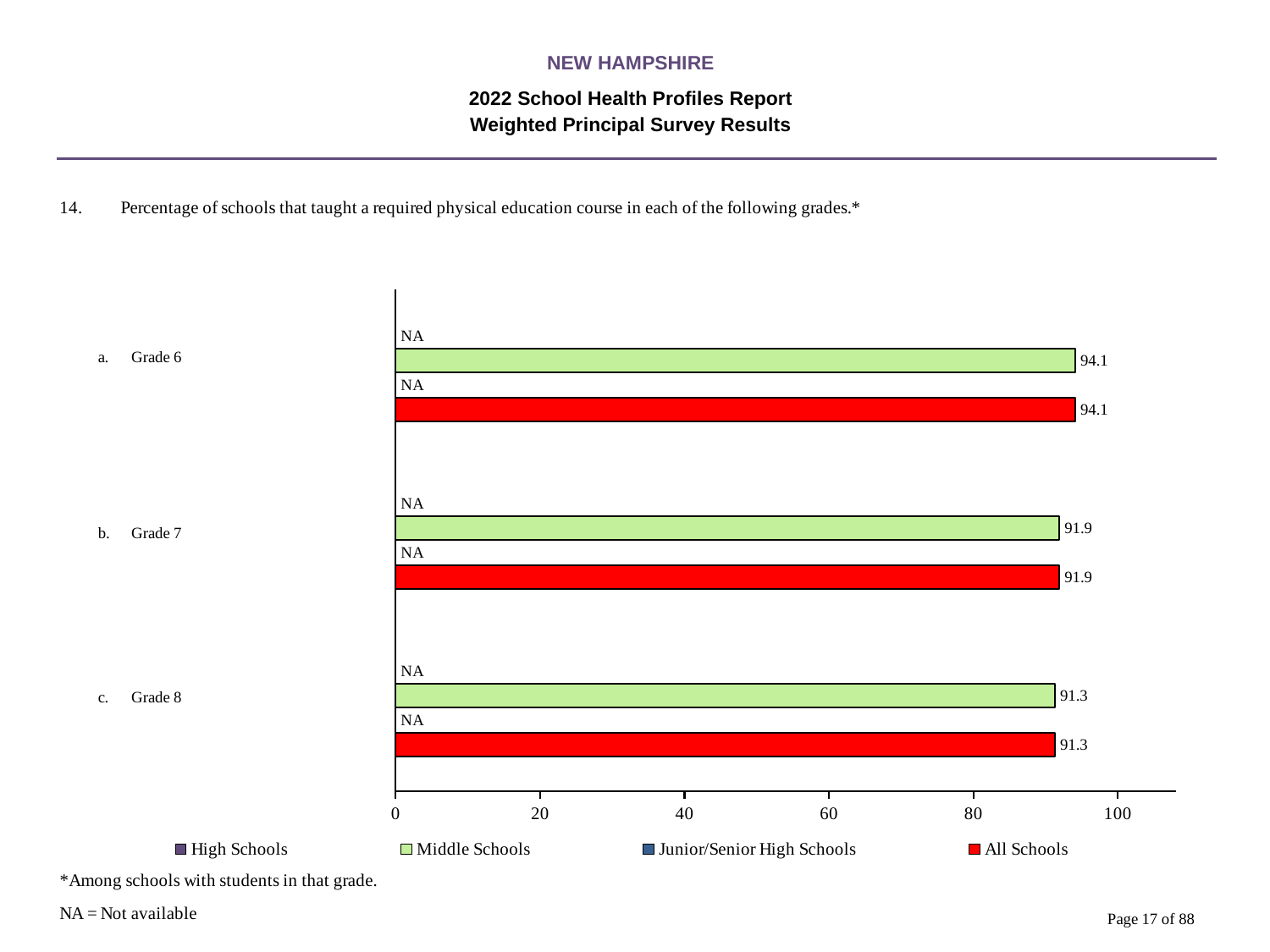
What is the difference between the Middle Schools values for Grade 6 and Grade 8? 2.8 What kind of chart is shown on the slide? bar chart What is the value for Middle Schools in Grade 6? 94.1 How many grade categories are shown on the chart? 3 What is shown for High Schools in Grade 6? NA How many series does the legend list? 4 Which series is shown in red in the legend? All Schools Which grade has the highest value for Middle Schools? Grade 6 What is the value for All Schools in Grade 7? 91.9 What is the value for Middle Schools in Grade 8? 91.3 Is the All Schools value for Grade 7 greater or less than 80? greater Which grade has the lowest value for All Schools? Grade 8